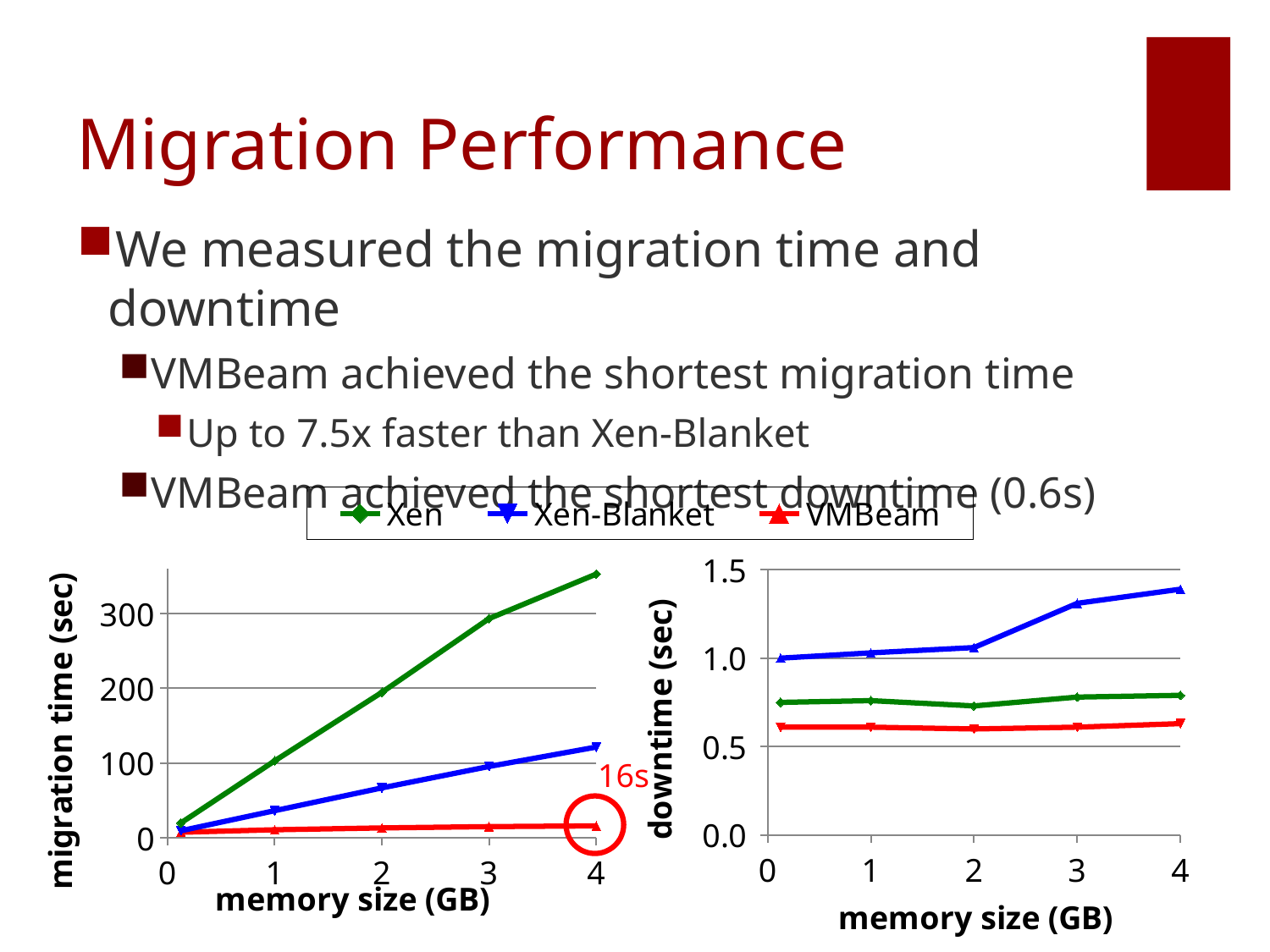
In the migration time chart, which series has the highest migration time at 4 GB? Xen In the migration time chart, what is the migration time for VMBeam at 4 GB memory size? 16s In the downtime chart, is the value for Xen-Blanket at 4 GB greater or less than 1.0? greater What is the y-axis label of the chart on the right? downtime (sec) In the downtime chart, is the value for VMBeam at 1 GB greater or less than 1.0? less In the downtime chart, which is larger at 4 GB: the downtime for Xen or for VMBeam? Xen In the downtime chart, which series has the lowest downtime across all memory sizes? VMBeam In the migration time chart, is the value for Xen-Blanket at 2 GB greater or less than 100? less How many series does the legend list? 3 In the migration time chart, does the migration time for Xen rise or fall as memory size increases? rises What kind of chart is the migration time chart on the left? line chart